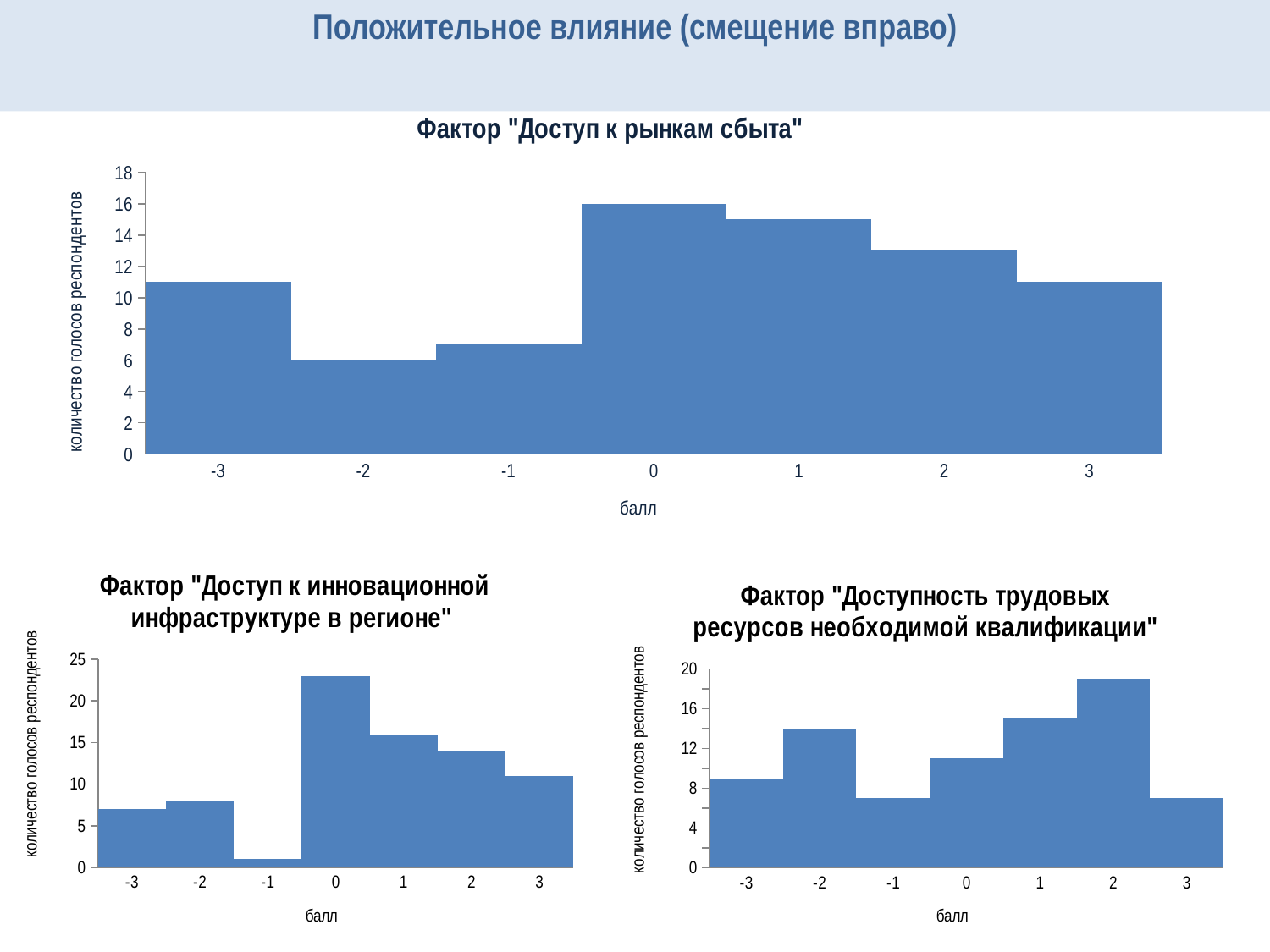
In the chart "Фактор "Доступность трудовых ресурсов необходимой квалификации"", which score has the highest number of respondents? 2 In the chart "Фактор "Доступ к рынкам сбыта"", which is larger, the value for score -3 or for score -2? -3 In the chart "Фактор "Доступ к инновационной инфраструктуре в регионе"", which score has the lowest number of respondents? -1 In the chart "Фактор "Доступность трудовых ресурсов необходимой квалификации"", is the value for score -1 greater or less than 8? less In the chart "Фактор "Доступ к рынкам сбыта"", is the value for score -3 greater or less than 10? greater How many score categories are shown on the x axis of the chart "Фактор "Доступ к рынкам сбыта""? 7 In the chart "Фактор "Доступность трудовых ресурсов необходимой квалификации"", which is larger, the value for score 2 or for score 1? 2 In the chart "Фактор "Доступ к инновационной инфраструктуре в регионе"", which score has the highest number of respondents? 0 In the chart "Фактор "Доступ к рынкам сбыта"", what is the number of respondents for score 0? 16 In the chart "Фактор "Доступ к инновационной инфраструктуре в регионе"", is the value for score 0 greater or less than 20? greater What kind of chart is "Фактор "Доступность трудовых ресурсов необходимой квалификации""? bar chart In the chart "Фактор "Доступ к рынкам сбыта"", what is the number of respondents for score -2? 6